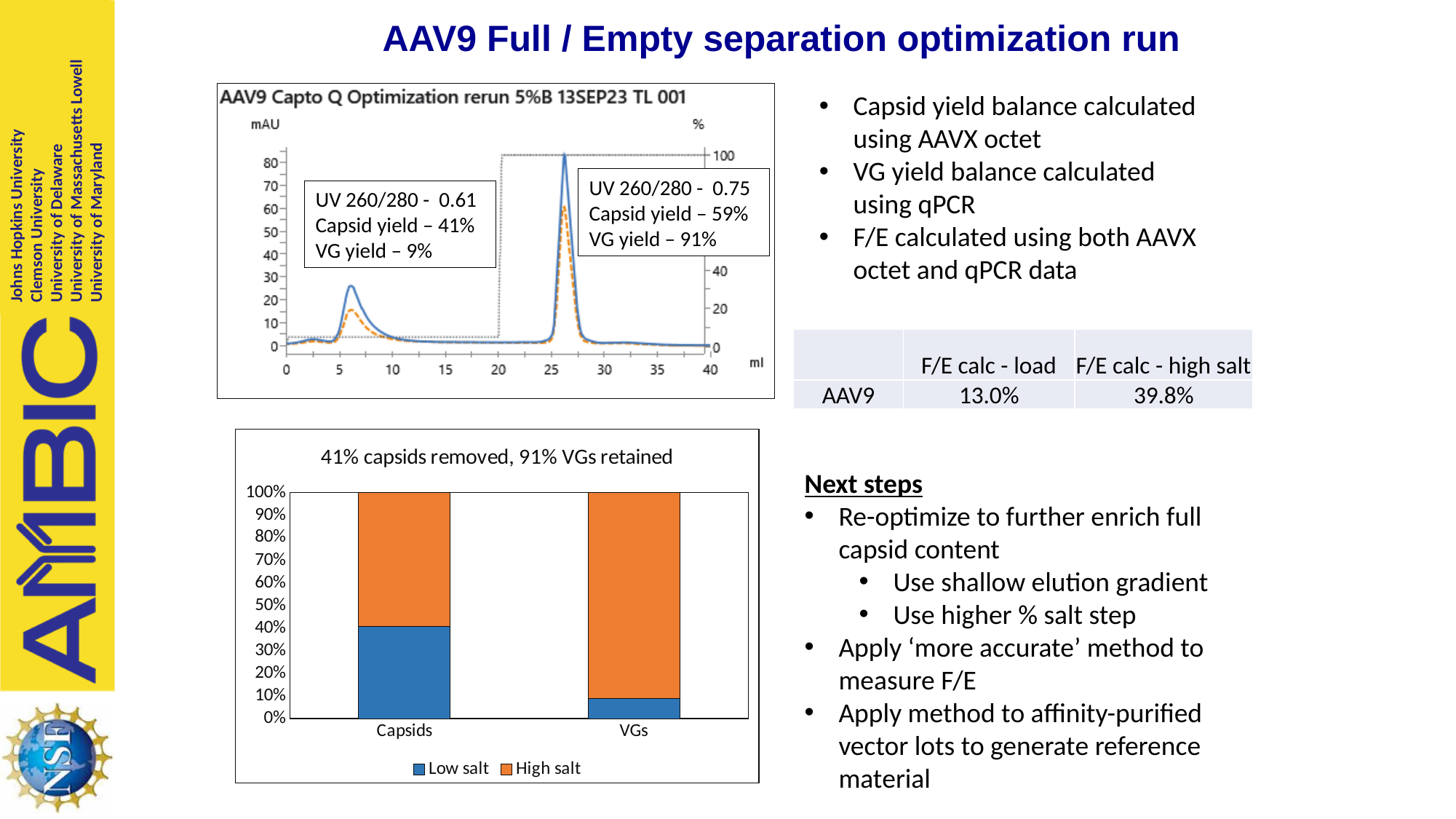
In the lower stacked bar chart, is the High salt value for VGs greater or less than 80%? greater In the lower stacked bar chart, what colour represents the High salt series? orange In the upper chromatogram chart, is the height of the peak near 26 ml greater or less than 60 mAU? greater What kind of chart is the lower chart titled "41% capsids removed, 91% VGs retained"? stacked bar chart In the lower stacked bar chart, is the Low salt value for Capsids greater or less than 30%? greater In the lower stacked bar chart, which category has the larger High salt share, Capsids or VGs? VGs In the lower stacked bar chart, which category has the larger Low salt share, Capsids or VGs? Capsids What kind of chart is the upper chart titled "AAV9 Capto Q Optimization rerun 5%B 13SEP23 TL 001"? line chart In the lower stacked bar chart, how many series does the legend list? 2 In the upper chromatogram chart, what is the unit shown on the x axis? ml In the lower stacked bar chart, how many categories are shown on the x axis? 2